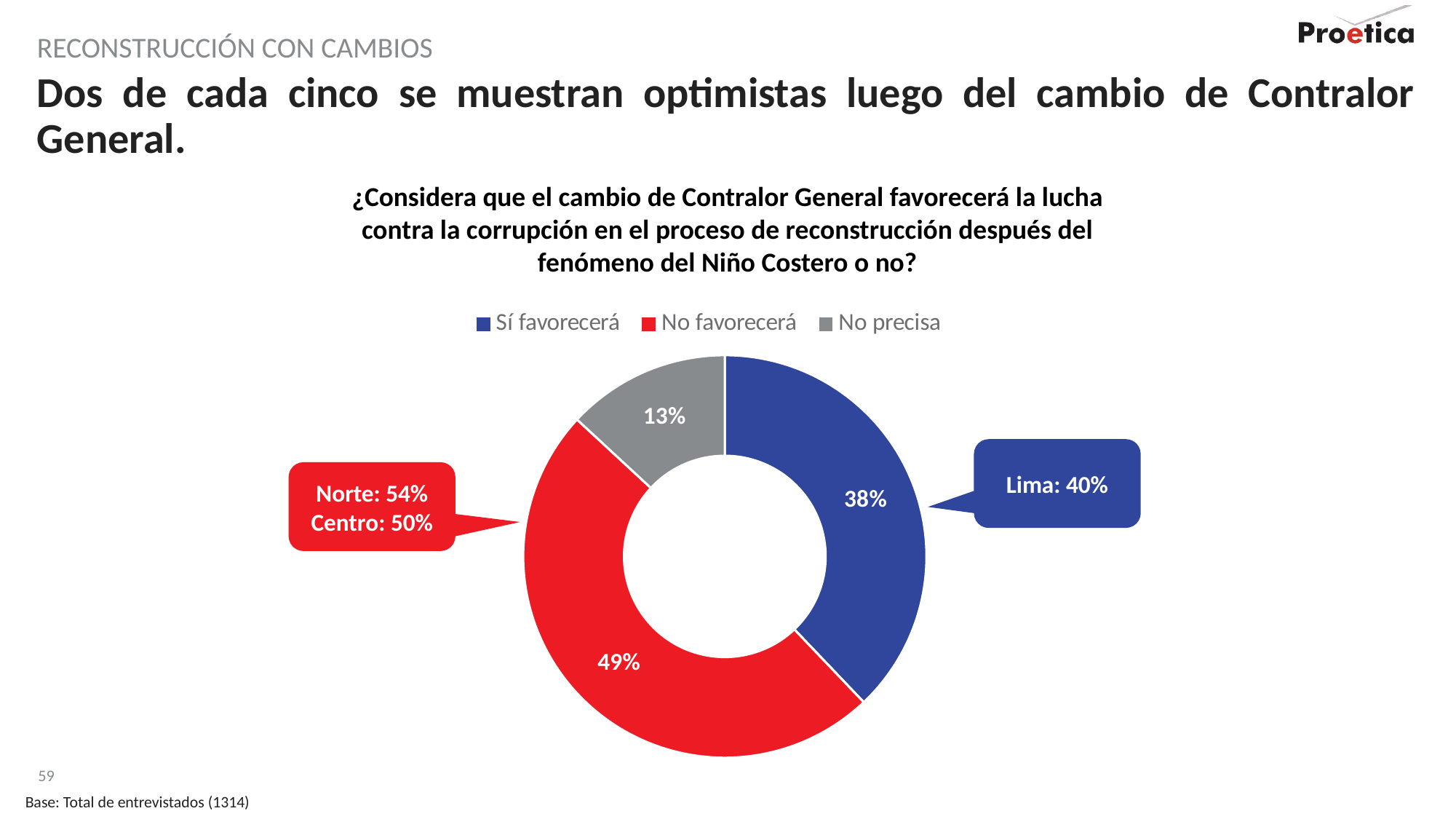
What percentage of respondents answered "Sí favorecerá"? 38% How many categories does the chart show? 3 What percentage of respondents answered "No favorecerá"? 49% According to the callout, what percentage in Lima answered "Sí favorecerá"? 40% What colour represents "No favorecerá" in the chart? Red Which response has the smallest share of the chart? No precisa What kind of chart is shown on the slide? Doughnut chart What percentage of respondents answered "No precisa"? 13% What is the difference in percentage points between "No favorecerá" and "Sí favorecerá"? 11 Which response has the largest share of the chart? No favorecerá Which is larger, the share for "Sí favorecerá" or the share for "No precisa"? Sí favorecerá How many entries does the legend list? 3